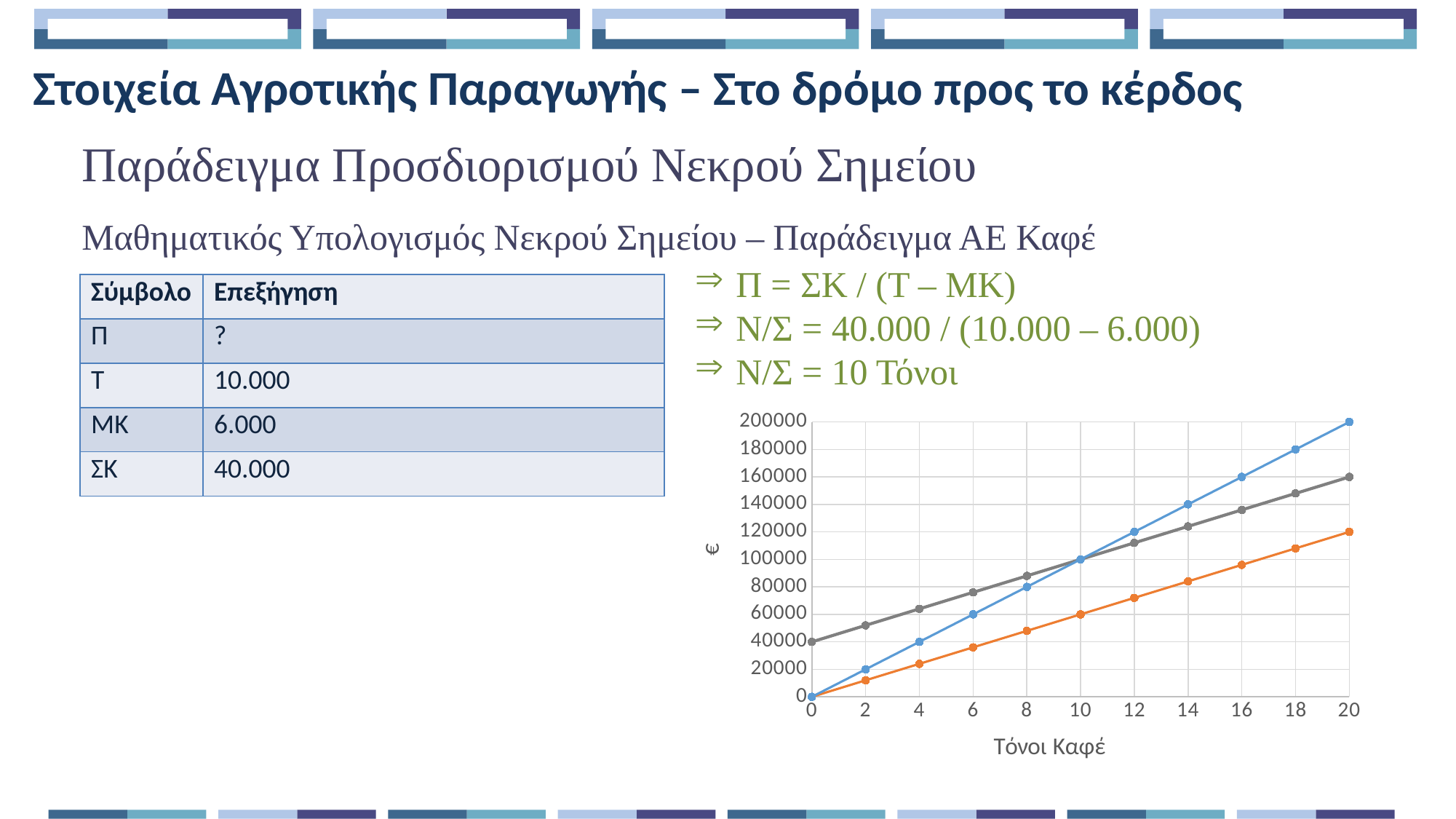
What is the value of the grey line at 20 Τόνοι Καφέ? 160000 How many lines are plotted on the chart? 3 What is the value of the grey line at 0 Τόνοι Καφέ? 40000 What is the label of the y axis of the chart? € At 20 Τόνοι Καφέ, which line has the higher value, the blue line or the orange line? blue line What is the value of the blue line at 20 Τόνοι Καφέ? 200000 Do the values of the blue line rise or fall as Τόνοι Καφέ increases? rise Is the value of the grey line at 4 Τόνοι Καφέ greater or less than 80000? less What kind of chart is shown on the slide? line chart What is the label of the x axis of the chart? Τόνοι Καφέ How many points are plotted along the x axis for each line? 11 What is the value of the orange line at 20 Τόνοι Καφέ? 120000